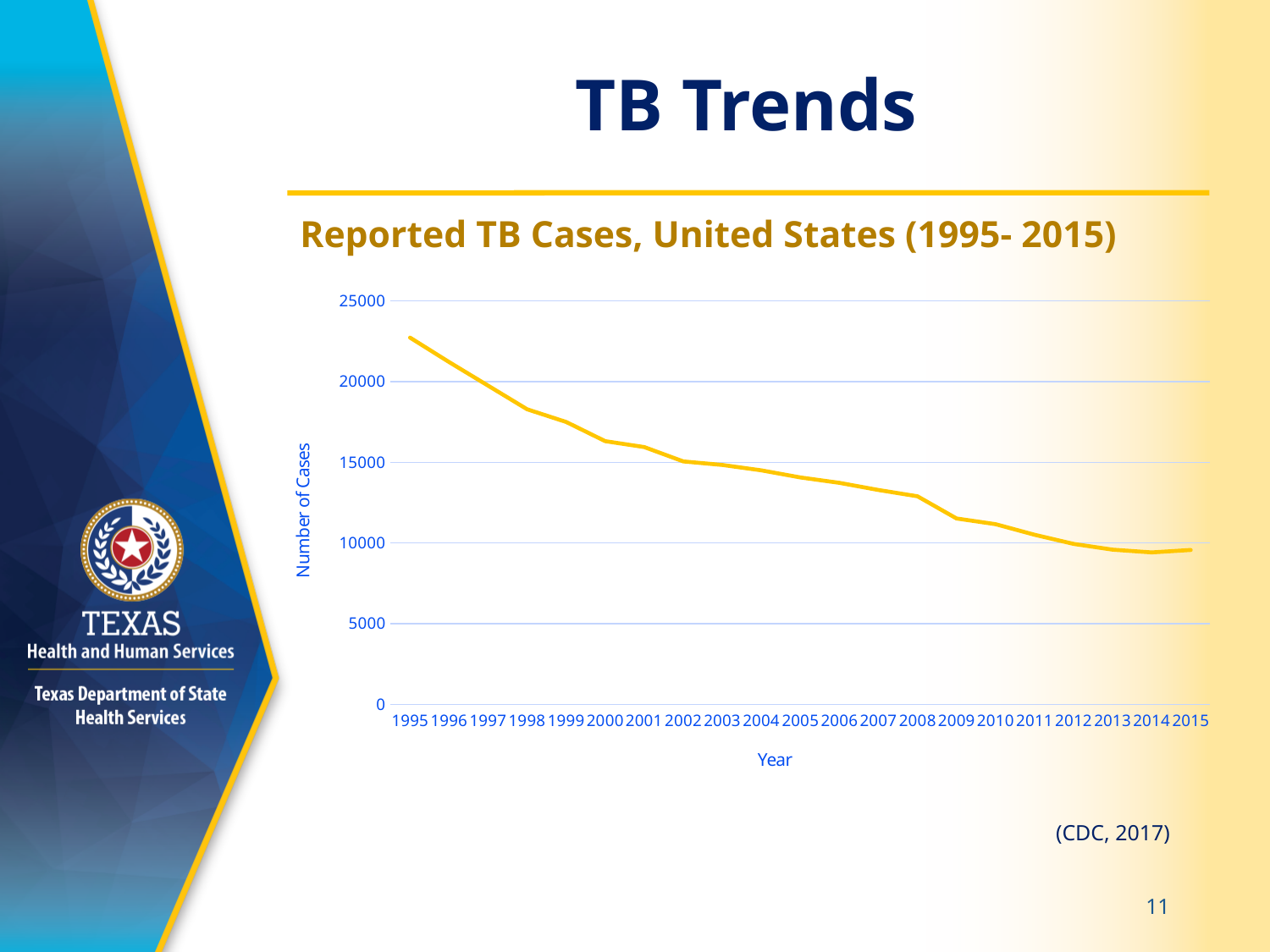
Do the reported TB cases rise or fall from 1995 to 2015? fall What is the label of the y axis? Number of Cases What is the title of the chart? Reported TB Cases, United States (1995- 2015) Which year has more reported TB cases, 2000 or 2010? 2000 Which year has the highest number of reported TB cases? 1995 Is the value for 2015 greater or less than 10000? less What kind of chart is shown on the slide? line chart Is the value for 1998 greater or less than 20000? less Is the value for 1995 greater or less than 20000? greater How many years are plotted on the x axis? 21